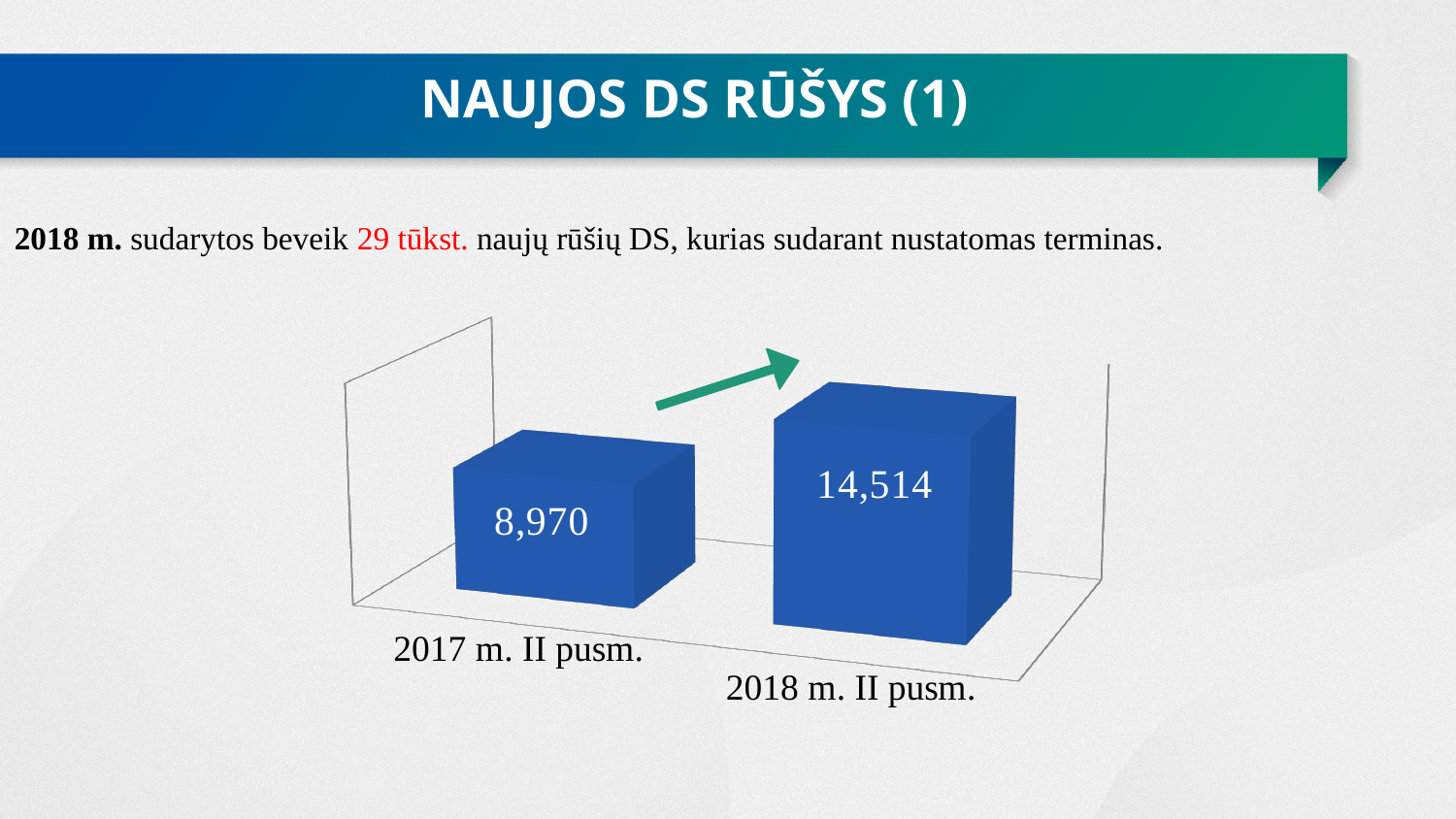
What colour are the bars in the chart? blue What is the title of the slide? NAUJOS DS RŪŠYS (1) Which category has the lowest value? 2017 m. II pusm. Which category has the highest value? 2018 m. II pusm. Which is larger, the value for 2017 m. II pusm. or 2018 m. II pusm.? 2018 m. II pusm. What kind of chart is shown on the slide? bar chart What is the value for 2017 m. II pusm.? 8,970 Do the values rise or fall from 2017 m. II pusm. to 2018 m. II pusm.? rise What is the value for 2018 m. II pusm.? 14,514 What is the difference between the values for 2018 m. II pusm. and 2017 m. II pusm.? 5,544 What is the total of the two values shown in the chart? 23,484 How many categories are shown in the chart? 2